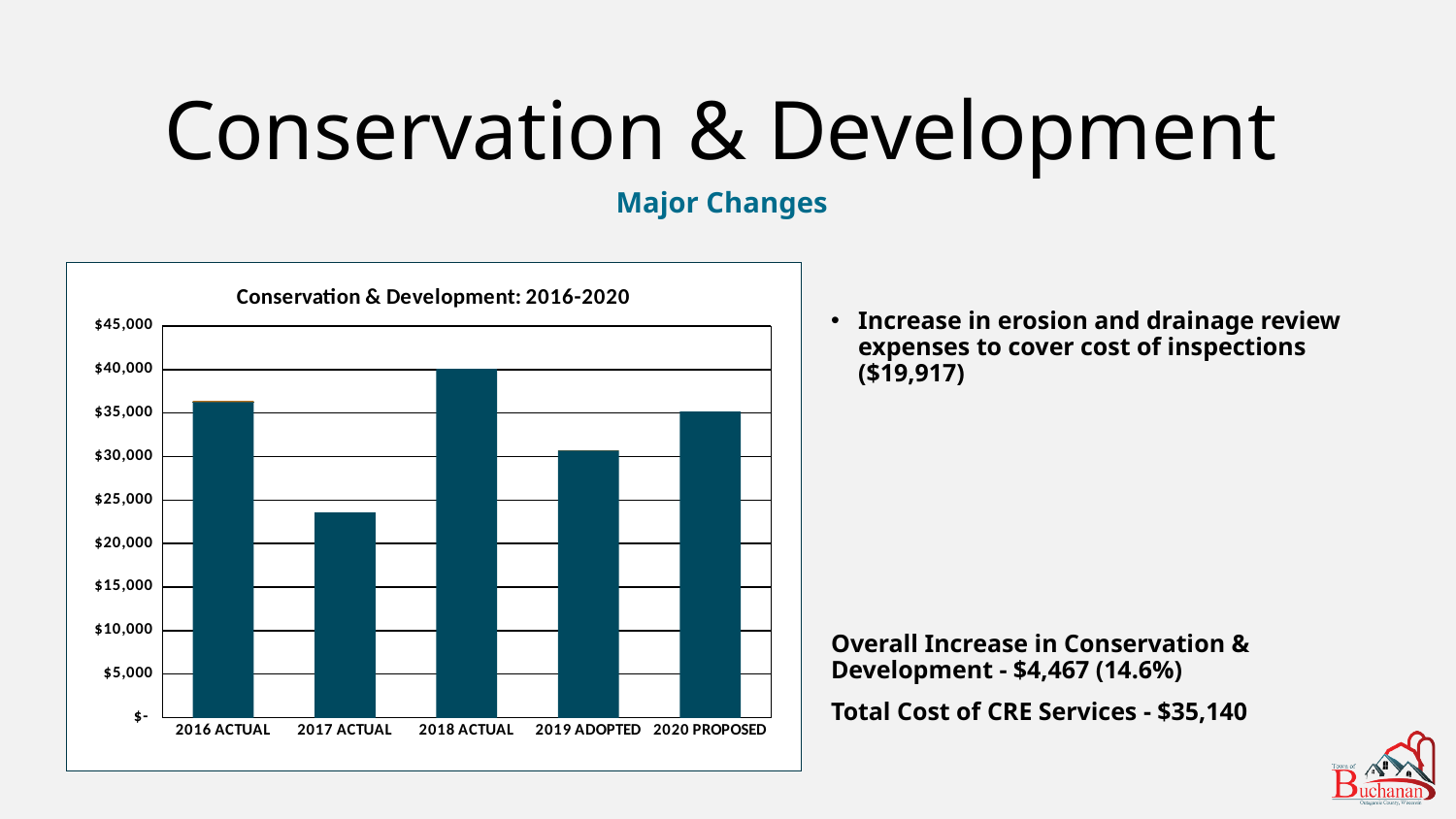
Is the value for 2018 ACTUAL greater or less than $35,000? greater Is the value for 2020 PROPOSED greater or less than $30,000? greater Is the value for 2019 ADOPTED greater or less than $35,000? less Which category has the highest value in the chart? 2018 ACTUAL Does the value rise or fall from 2018 ACTUAL to 2019 ADOPTED? fall How many categories are shown on the x axis of the chart? 5 What is the title of the chart? Conservation & Development: 2016-2020 Which is larger, the value for 2016 ACTUAL or the value for 2019 ADOPTED? 2016 ACTUAL What kind of chart is shown on the slide? bar chart Which category has the lowest value in the chart? 2017 ACTUAL